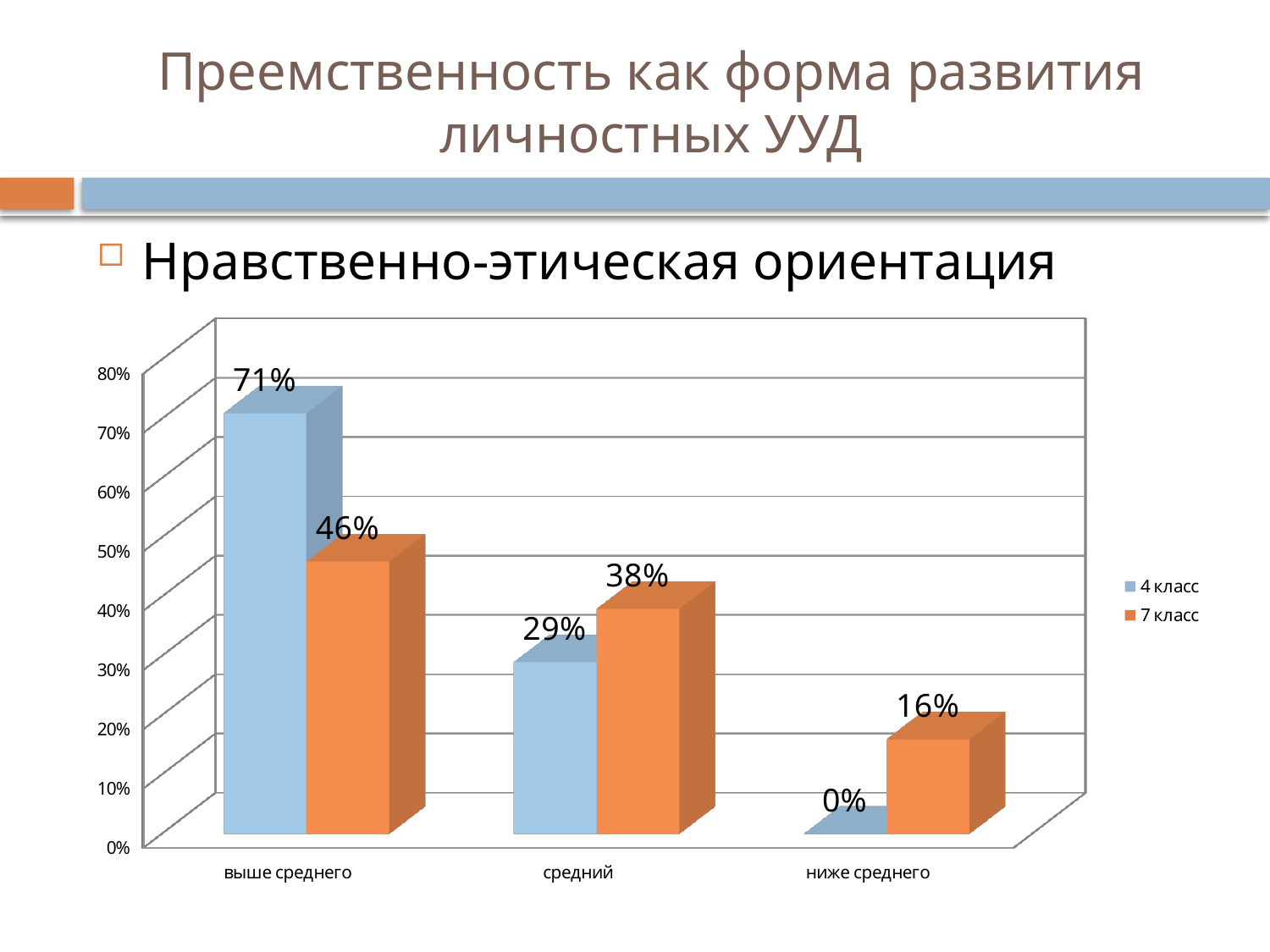
What is the value for 4 класс in the ниже среднего category? 0% In the средний category, which series has the larger value, 4 класс or 7 класс? 7 класс What is the value for 4 класс in the выше среднего category? 71% How many categories are shown on the x axis? 3 How many series does the legend list? 2 What is the value for 7 класс in the средний category? 38% What kind of chart is shown on the slide? bar chart Which category has the lowest value for 7 класс? ниже среднего Which category has the highest value for 4 класс? выше среднего Do the values for 4 класс rise or fall from left to right along the x axis? fall What is the value for 7 класс in the ниже среднего category? 16% What is the difference between the 4 класс and 7 класс values in the выше среднего category? 25%